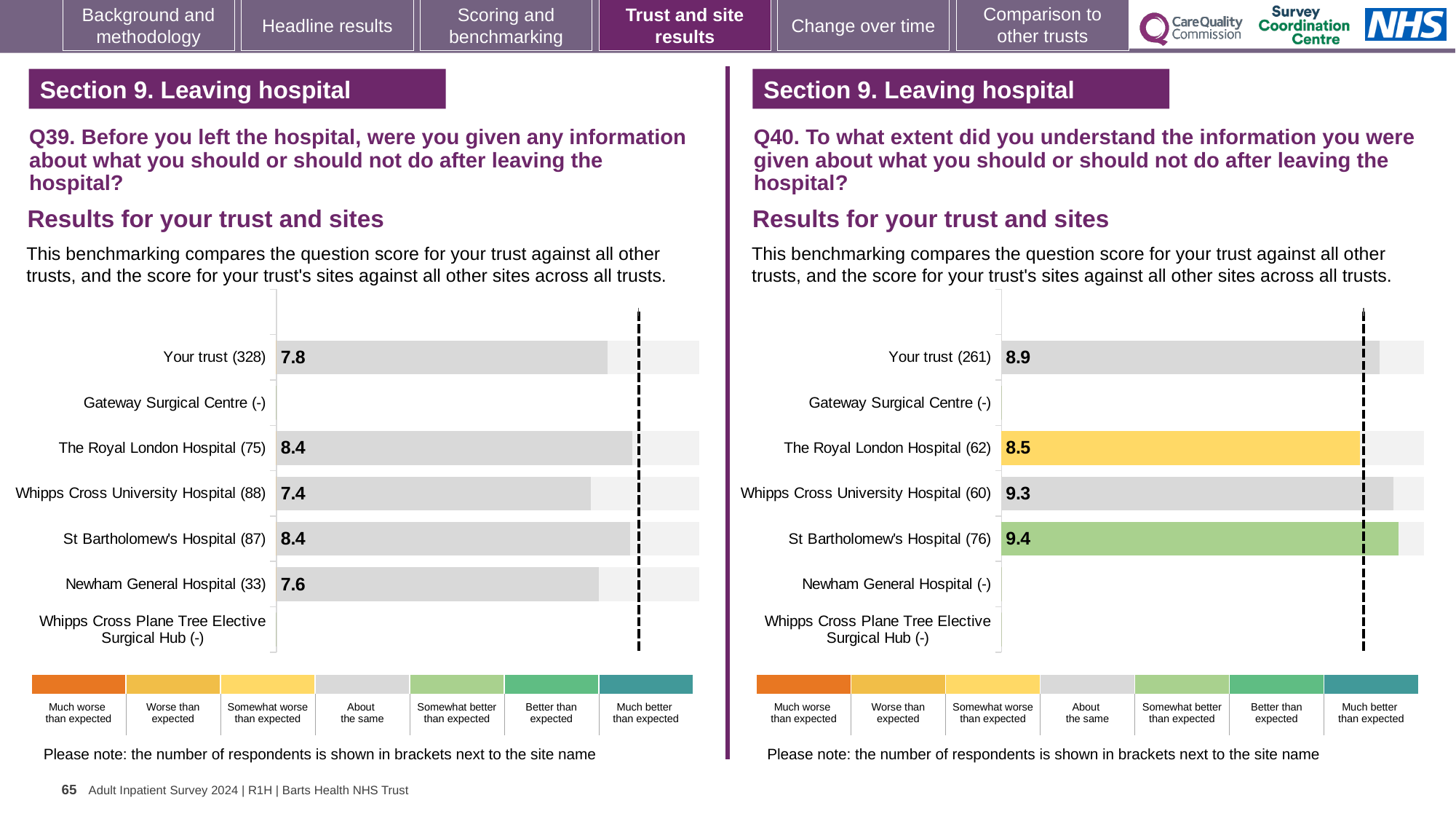
On the Q39 chart (left), what is the score for Whipps Cross University Hospital? 7.4 What kind of chart is used on the Q39 chart (left)? Bar chart On the Q40 chart (right), what is the difference between the scores for Whipps Cross University Hospital and The Royal London Hospital? 0.8 On the Q39 chart (left), how many respondents are shown in brackets for St Bartholomew's Hospital? 87 On the Q40 chart (right), which site has the highest score? St Bartholomew's Hospital On the Q40 chart (right), what is the score for St Bartholomew's Hospital? 9.4 On the Q39 chart (left), which site has the lowest score? Whipps Cross University Hospital On the Q40 chart (right), how many sites have a score value displayed? 3 On the Q39 chart (left), what is the score for Your trust? 7.8 On the Q40 chart (right), which is larger: the score for Your trust or the score for Whipps Cross University Hospital? Whipps Cross University Hospital On the Q40 chart (right), which site has the lowest score among those with a value shown? The Royal London Hospital On the Q39 chart (left), what is the difference between the scores for The Royal London Hospital and Newham General Hospital? 0.8